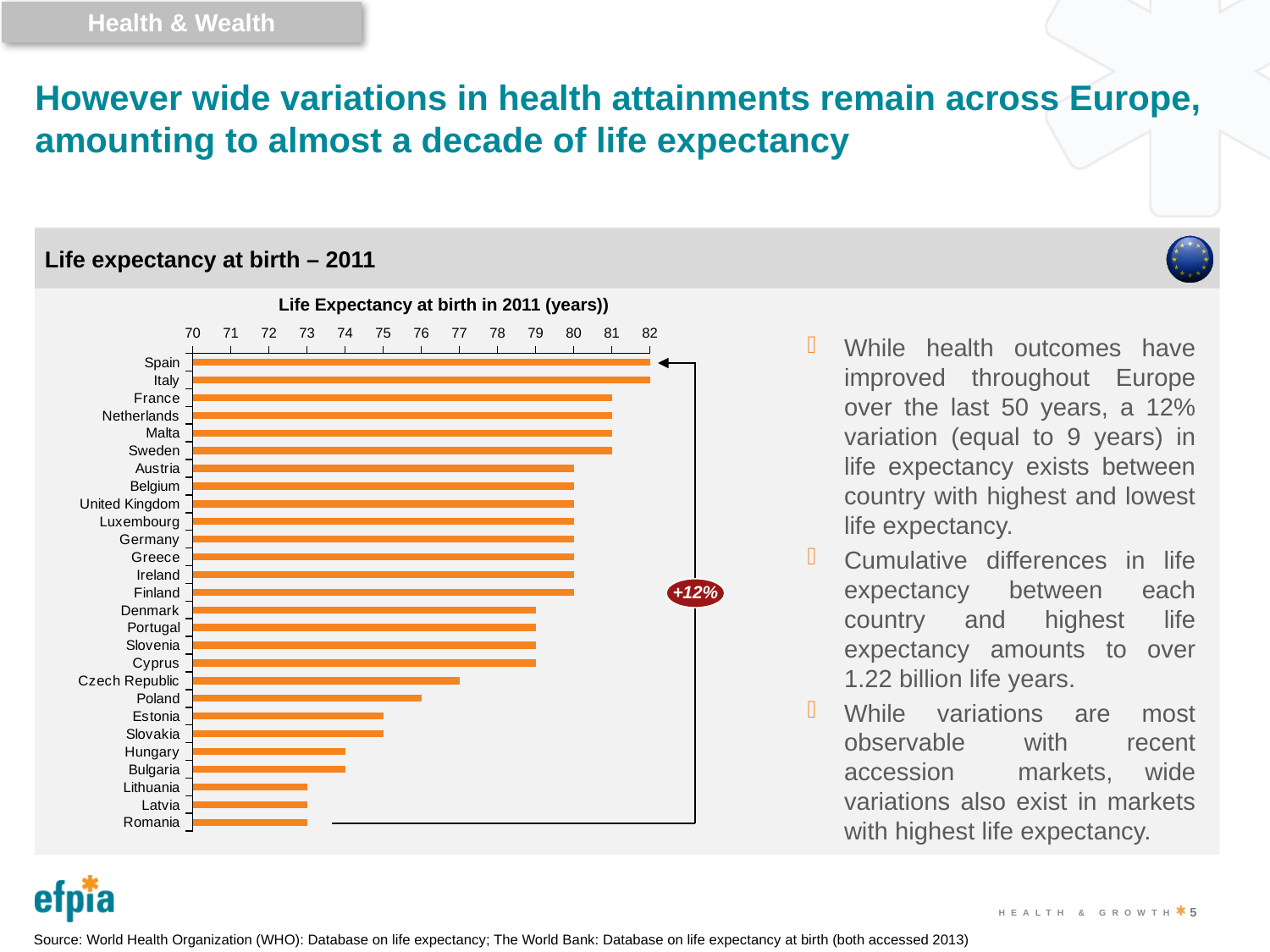
What is the life expectancy at birth for Romania in the chart? 73 What type of chart is shown on the slide? Bar chart What is the title of the chart? Life Expectancy at birth in 2011 (years)) How many countries are shown in the chart? 27 What is the life expectancy at birth for Denmark in the chart? 79 What is the life expectancy at birth for France in the chart? 81 Which has a higher life expectancy at birth, Spain or Hungary? Spain What is the life expectancy at birth for Czech Republic in the chart? 77 What is the difference in life expectancy at birth between Spain and Romania? 9 Is the value for Bulgaria greater or less than 76? less Which has a lower life expectancy at birth, Estonia or Austria? Estonia What is the life expectancy at birth for Poland in the chart? 76